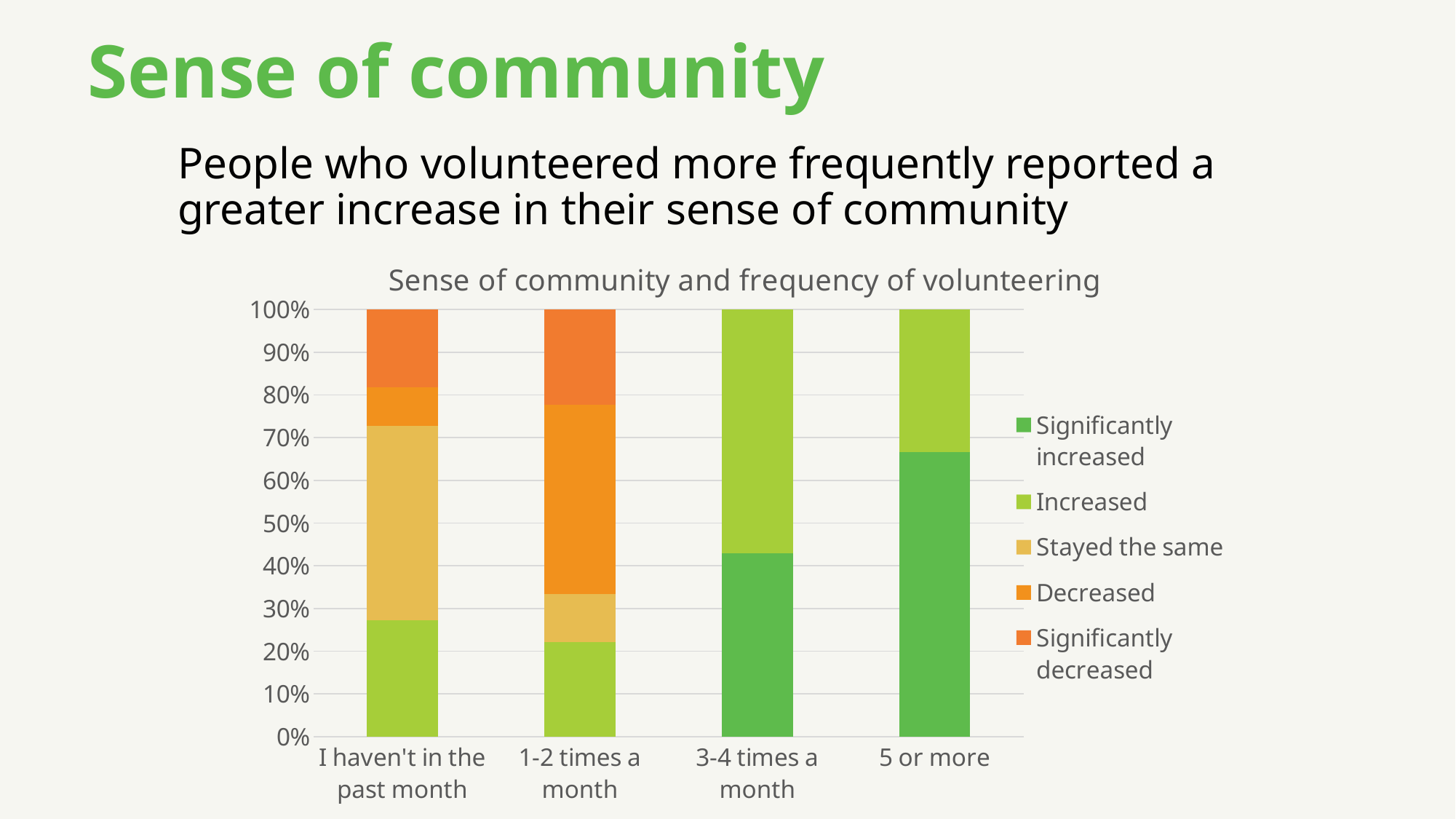
Which category has the largest 'Decreased' share? 1-2 times a month What does each stacked bar total? 100% How many volunteering frequency categories are shown on the x axis? 4 Which legend entry is shown in the darkest green colour? Significantly increased Which category has the largest 'Significantly increased' share? 5 or more How many series does the legend list? 5 Is the 'Increased' share for 'I haven't in the past month' greater or less than 20%? greater Is the 'Significantly increased' share for '5 or more' greater or less than 60%? greater What kind of chart is shown on the slide? Stacked bar chart What is the title of the chart? Sense of community and frequency of volunteering Is the 'Significantly increased' share for '3-4 times a month' greater or less than 50%? less Which category has the larger 'Significantly increased' share: '3-4 times a month' or '5 or more'? 5 or more